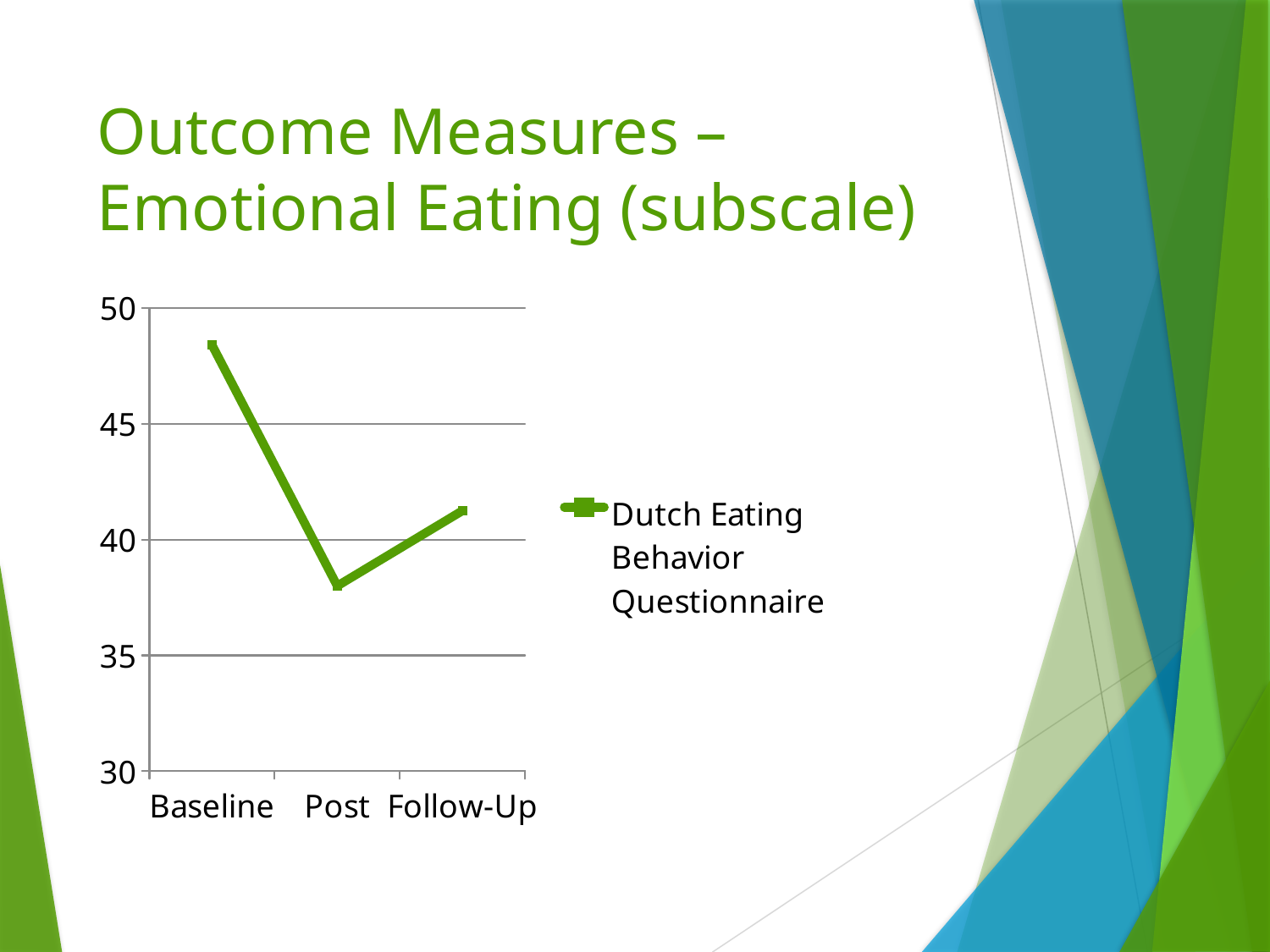
Is the value at Baseline greater or less than 45? greater How many time points are plotted on the x axis? 3 What is the name of the series shown in the legend? Dutch Eating Behavior Questionnaire Is the value at Post greater or less than 40? less At which time point is the Dutch Eating Behavior Questionnaire score lowest? Post How many series does the legend list? 1 Which is larger, the score at Baseline or the score at Follow-Up? Baseline What kind of chart is shown on the slide? Line chart Does the score rise or fall from Baseline to Post? Fall Which is larger, the score at Post or the score at Follow-Up? Follow-Up At which time point is the Dutch Eating Behavior Questionnaire score highest? Baseline Is the value at Follow-Up greater or less than 40? greater